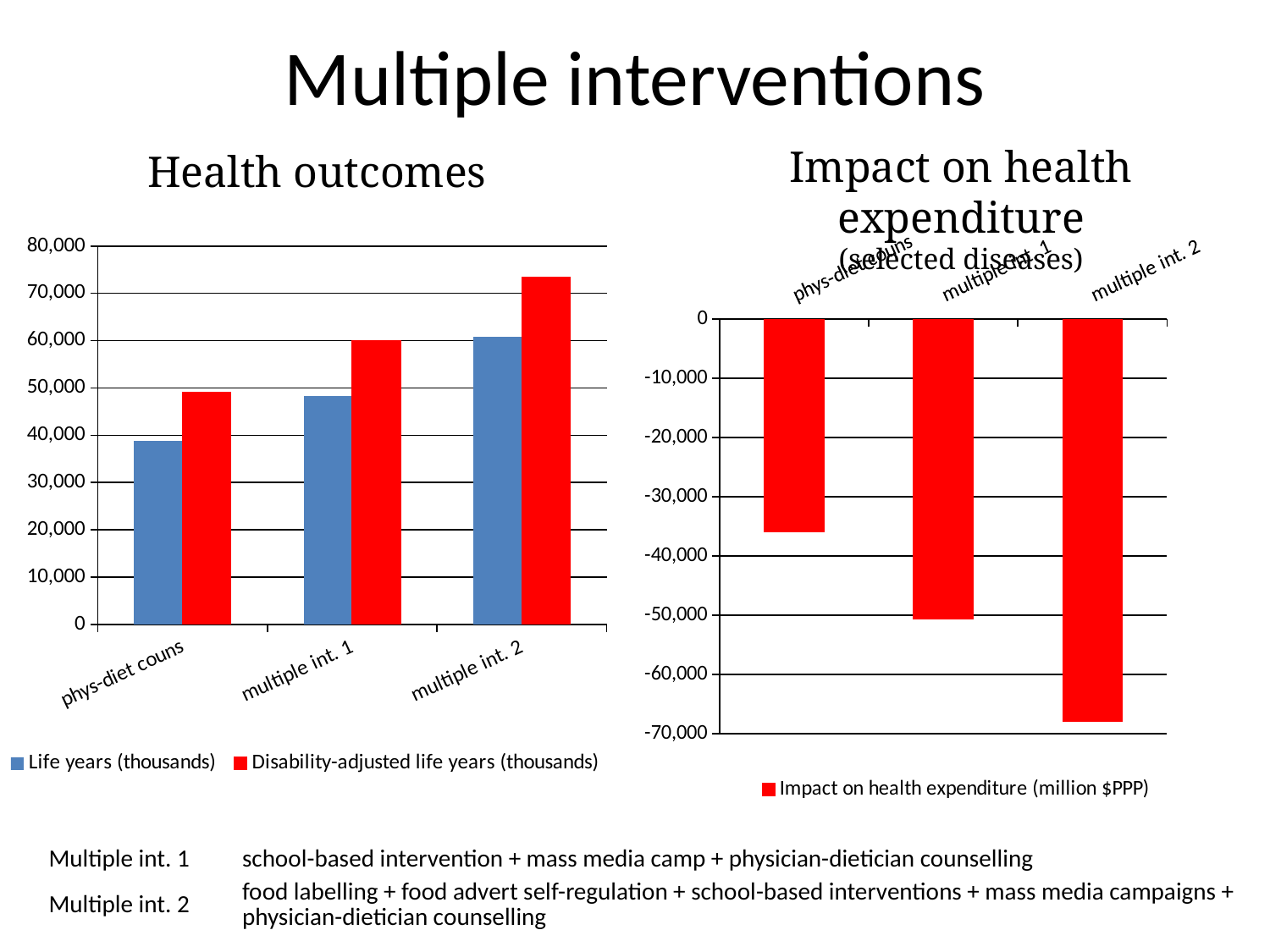
In the Health outcomes chart, is the Disability-adjusted life years value for multiple int. 2 greater or less than 70,000? greater In the Impact on health expenditure chart, how many categories are shown? 3 In the Impact on health expenditure chart, what is the legend entry for the series? Impact on health expenditure (million $PPP) In the Health outcomes chart, which category has the highest Disability-adjusted life years (thousands)? multiple int. 2 In the Health outcomes chart, what kind of chart is shown? bar chart In the Impact on health expenditure chart, is the value for phys-diet couns greater or less than -30,000? less In the Health outcomes chart, for multiple int. 1, which is larger: Life years (thousands) or Disability-adjusted life years (thousands)? Disability-adjusted life years (thousands) In the Health outcomes chart, how many intervention categories are shown on the x axis? 3 In the Health outcomes chart, do the Life years values rise or fall from phys-diet couns to multiple int. 2? rise In the Health outcomes chart, which category has the lowest Life years (thousands)? phys-diet couns In the Impact on health expenditure chart, which category has the lowest (most negative) value? multiple int. 2 In the Health outcomes chart, how many series does the legend list? 2